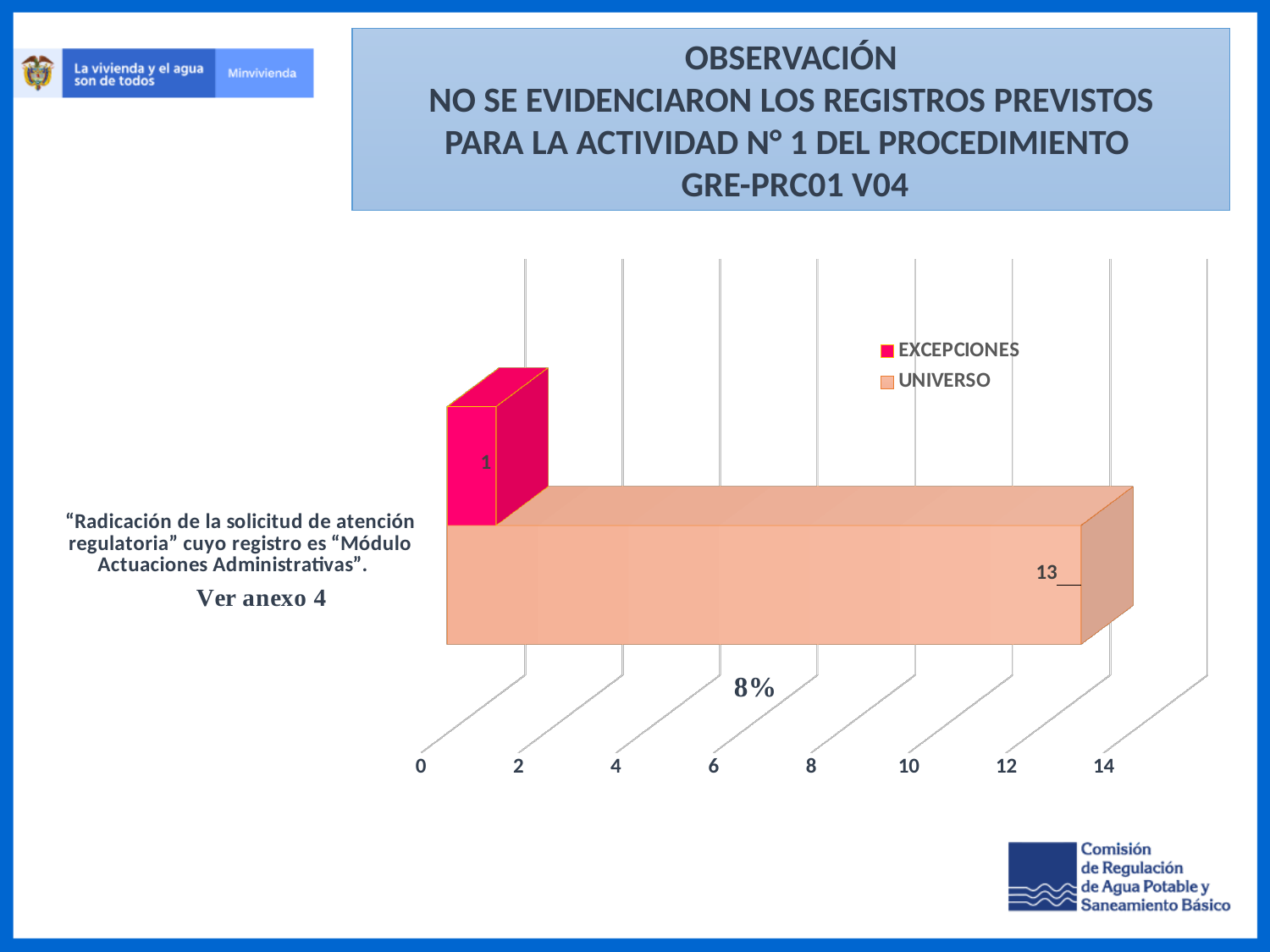
How many series does the legend list? 2 What percentage label is printed below the bars? 8% Which series has the larger value, EXCEPCIONES or UNIVERSO? UNIVERSO What is the difference between the UNIVERSO value and the EXCEPCIONES value? 12 What kind of chart is shown on the slide? Bar chart What is the highest value shown on the horizontal axis? 14 What is the value of the UNIVERSO bar? 13 What is the value of the EXCEPCIONES bar? 1 Is the value for UNIVERSO greater or less than 10? greater Is the value for EXCEPCIONES greater or less than 2? less Which series is shown in pink/magenta in the legend? EXCEPCIONES How many categories are plotted on the chart? 1